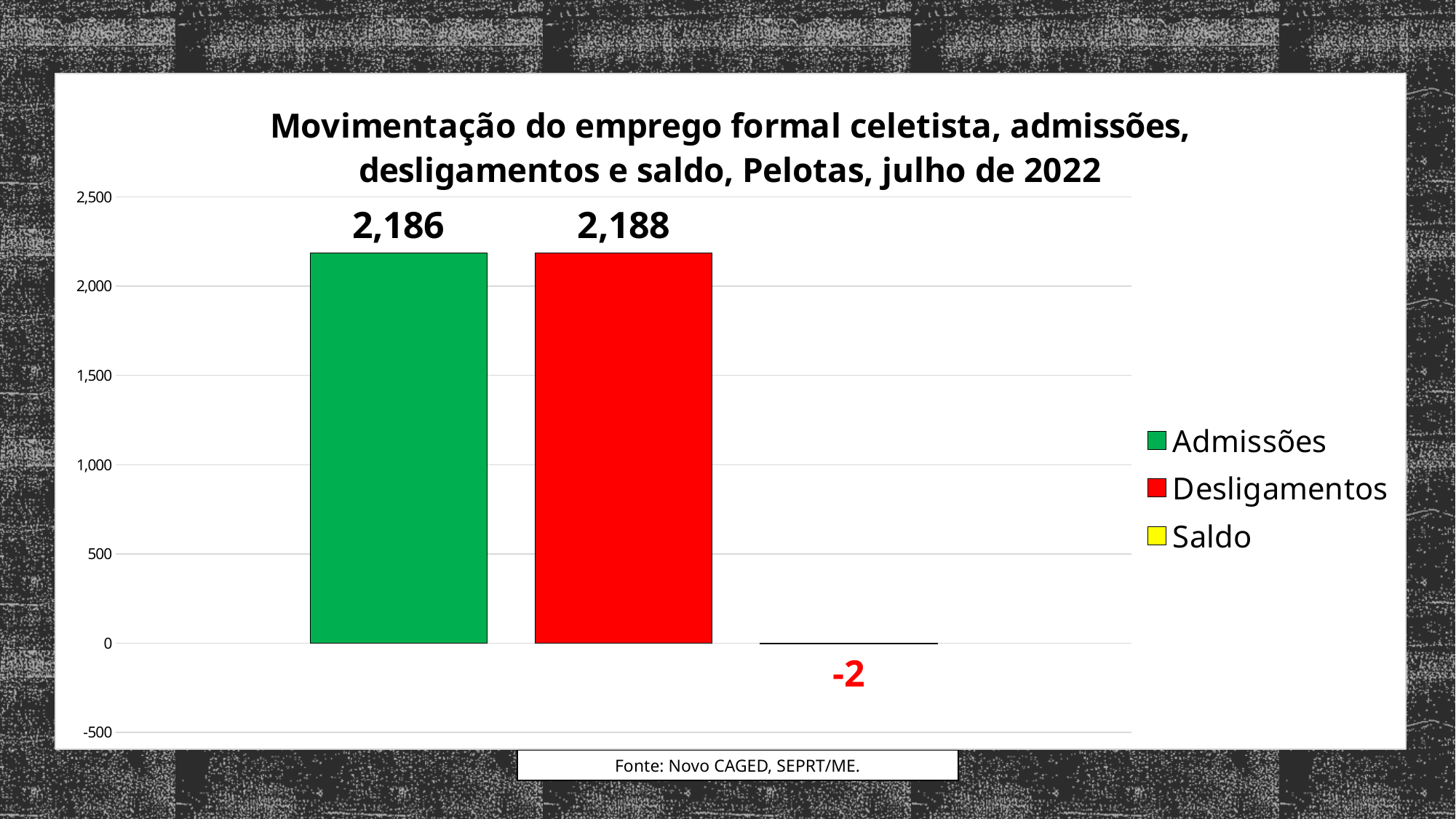
Is the value for Admissões greater or less than 2,000? greater What is the difference between Desligamentos and Admissões? 2 What colour is used for the Desligamentos series in the legend? red How many series does the legend list? 3 Which is larger, Admissões or Saldo? Admissões What is the value for Admissões? 2,186 What kind of chart is shown on the slide? bar chart Which series has the lowest value? Saldo What is the value for Saldo? -2 What source is cited below the chart? Fonte: Novo CAGED, SEPRT/ME. Is the value for Desligamentos greater or less than 2,500? less What is the value for Desligamentos? 2,188